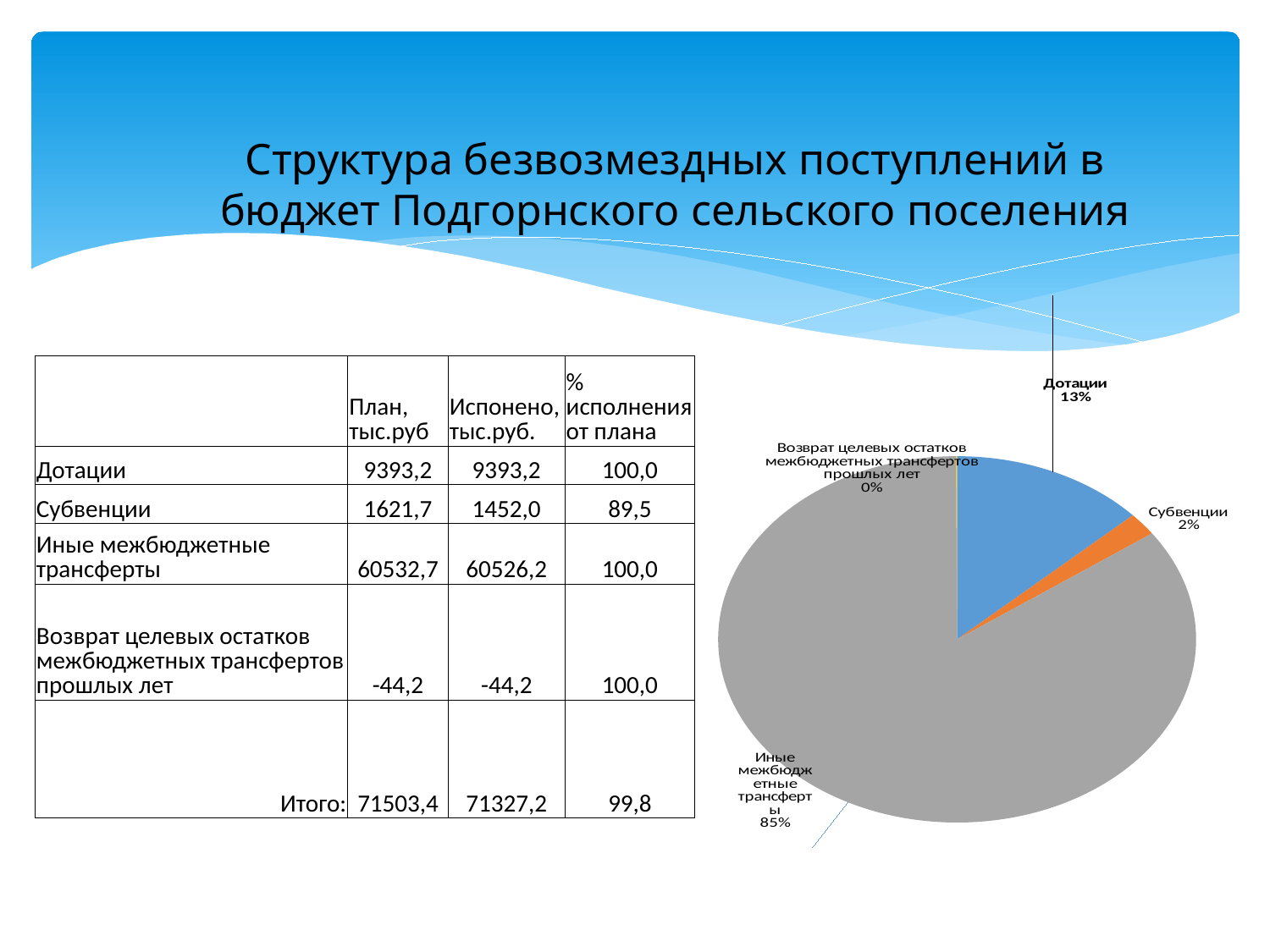
What share of the pie does Иные межбюджетные трансферты represent? 85% Which slice is larger, Дотации or Субвенции? Дотации How many slices does the pie chart have? 4 What colour is the Субвенции slice? orange By how many percentage points does the Иные межбюджетные трансферты share exceed the Дотации share? 72 What share of the pie does Возврат целевых остатков межбюджетных трансфертов прошлых лет represent? 0% What share of the pie does Дотации represent? 13% What colour is the Иные межбюджетные трансферты slice? grey Which category has the smallest slice of the pie? Возврат целевых остатков межбюджетных трансфертов прошлых лет What kind of chart is shown on the slide? pie chart Which category has the largest slice of the pie? Иные межбюджетные трансферты